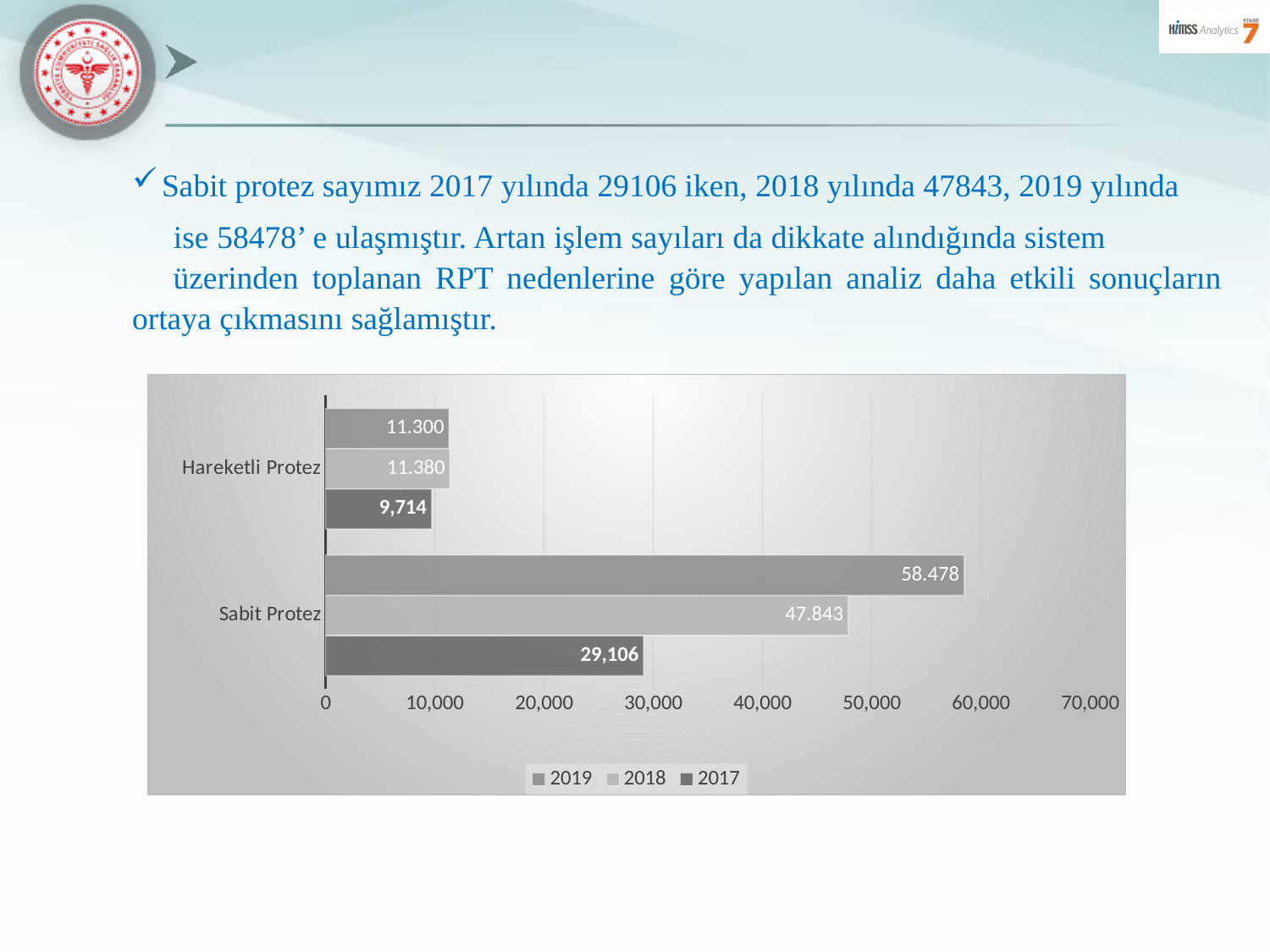
Which year has the lowest value for Sabit Protez? 2017 Is the value for Sabit Protez in 2018 greater or less than 40,000? greater Which category has the highest value in 2019? Sabit Protez Which is larger: Sabit Protez in 2018 or Hareketli Protez in 2018? Sabit Protez in 2018 What is the value for Hareketli Protez in 2017? 9,714 What is the value for Hareketli Protez in 2018? 11.380 What is the difference between the 2019 and 2018 values for Sabit Protez? 10.635 How many categories are shown on the chart? 2 How many series does the legend list? 3 What is the value for Sabit Protez in 2019? 58.478 What is the value for Sabit Protez in 2017? 29,106 What kind of chart is shown on the slide? bar chart